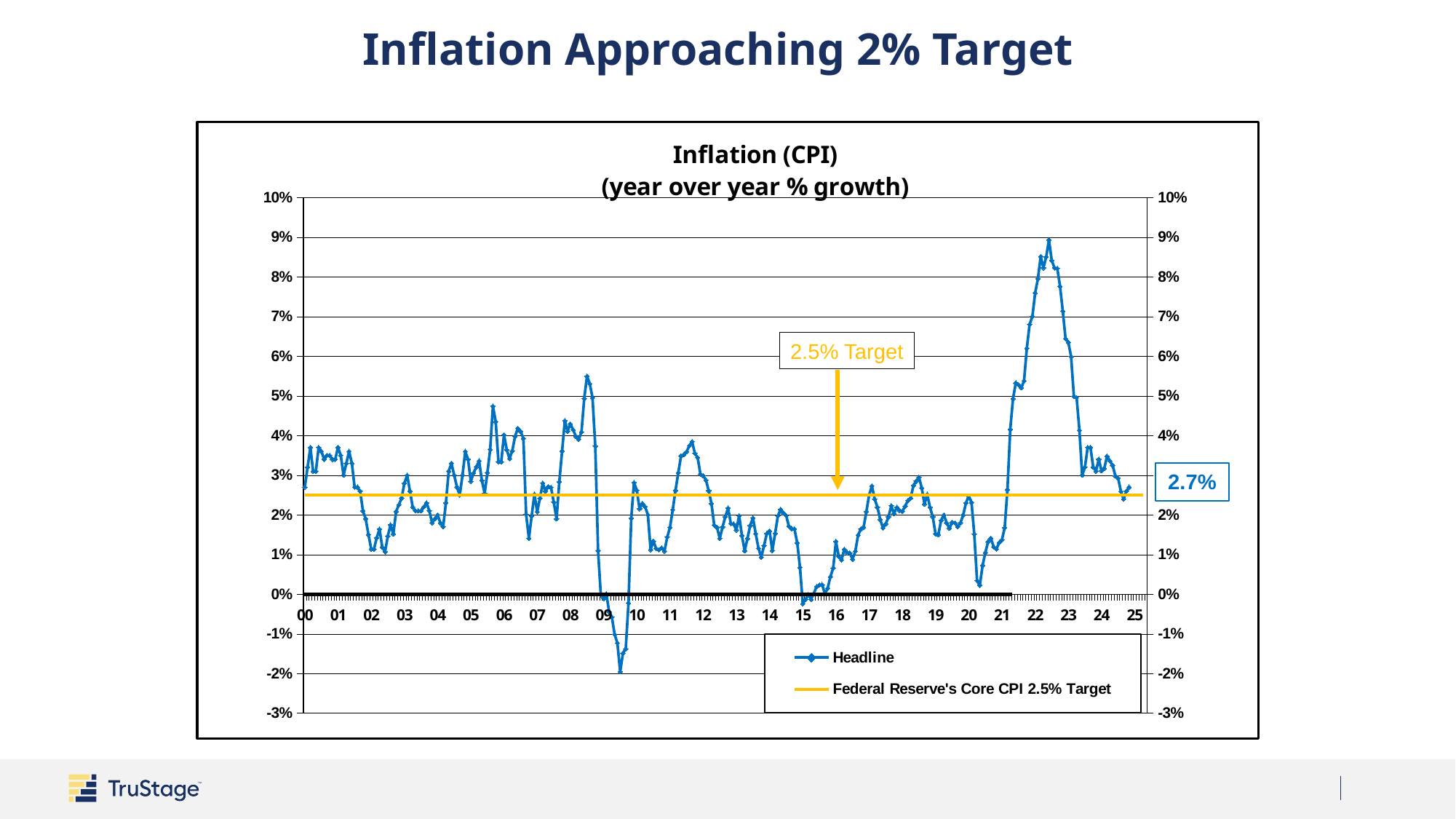
What kind of chart is shown on the slide? Line chart Is the peak Headline inflation value in 2022 greater or less than 8%? greater How many series does the legend list? 2 What is the most recent Headline inflation value labeled on the chart? 2.7% Is the lowest Headline inflation value in 2009 greater or less than -1%? less From 2022 to 2024, does the Headline inflation line rise or fall? Fall Is the Headline inflation value in 2015 greater or less than 1%? less What value is the Federal Reserve's Core CPI target line set at? 2.5% What is the title of the chart? Inflation (CPI) (year over year % growth) In which year does the Headline inflation line reach its highest point? 22 In which year does the Headline inflation line reach its lowest point? 09 Which peak is higher: the Headline inflation peak in 2008 or the peak in 2022? 2022